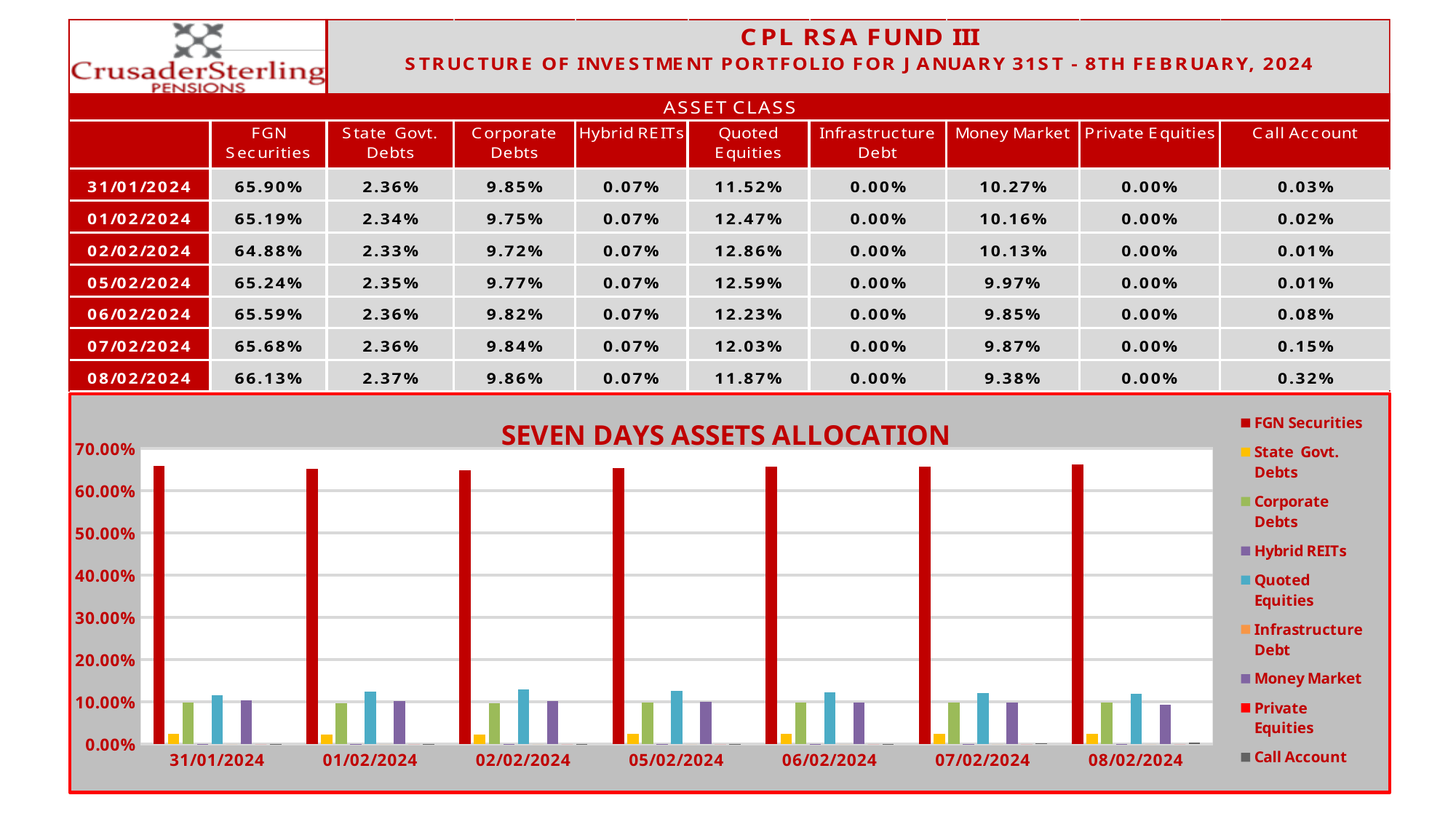
What is the Money Market allocation on 05/02/2024? 9.97% What kind of chart is shown on the slide? bar chart How many dates are plotted along the x axis of the chart? 7 Is the value for Quoted Equities on 02/02/2024 greater or less than 20.00%? less Is the value for FGN Securities on 31/01/2024 greater or less than 60.00%? greater How many series does the chart legend list? 9 On 08/02/2024, which is larger: Quoted Equities or Money Market? Quoted Equities Which asset class has the highest allocation on every date in the chart? FGN Securities What is the title of the chart? SEVEN DAYS ASSETS ALLOCATION By how much did the Quoted Equities allocation on 02/02/2024 exceed that on 31/01/2024? 1.34% What is the FGN Securities allocation on 08/02/2024? 66.13% Does the Call Account allocation rise or fall from 02/02/2024 to 08/02/2024? rise